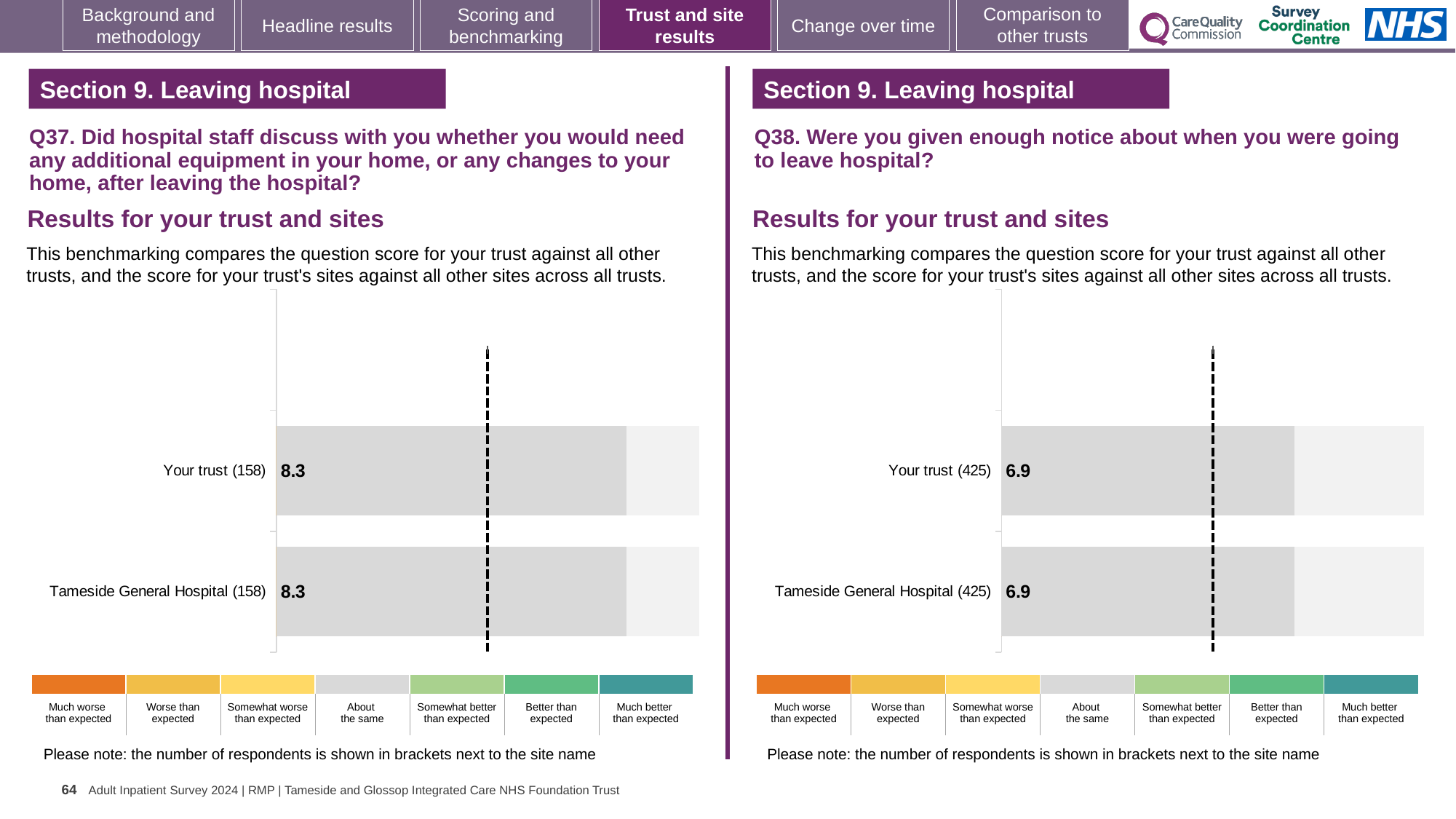
On the Q38 chart (right), what is the difference between the score for Your trust and the score for Tameside General Hospital? 0 On the Q37 chart (left), what is the score for Your trust? 8.3 On the Q38 chart (right), what is the score for Your trust? 6.9 On the Q37 chart (left), what is the score for Tameside General Hospital? 8.3 On the Q38 chart (right), what is the score for Tameside General Hospital? 6.9 On the Q38 chart (right), how many respondents are shown in brackets next to Tameside General Hospital? 425 On the Q37 chart (left), what is the difference between the score for Your trust and the score for Tameside General Hospital? 0 How many bars are plotted on the Q37 chart (left)? 2 On the Q37 chart (left), how many respondents are shown in brackets next to Your trust? 158 What kind of chart is used on the Q38 chart (right)? Bar chart How many bars are plotted on the Q38 chart (right)? 2 Is the score for Your trust on the Q37 chart (left) larger or smaller than the score for Your trust on the Q38 chart (right)? Larger